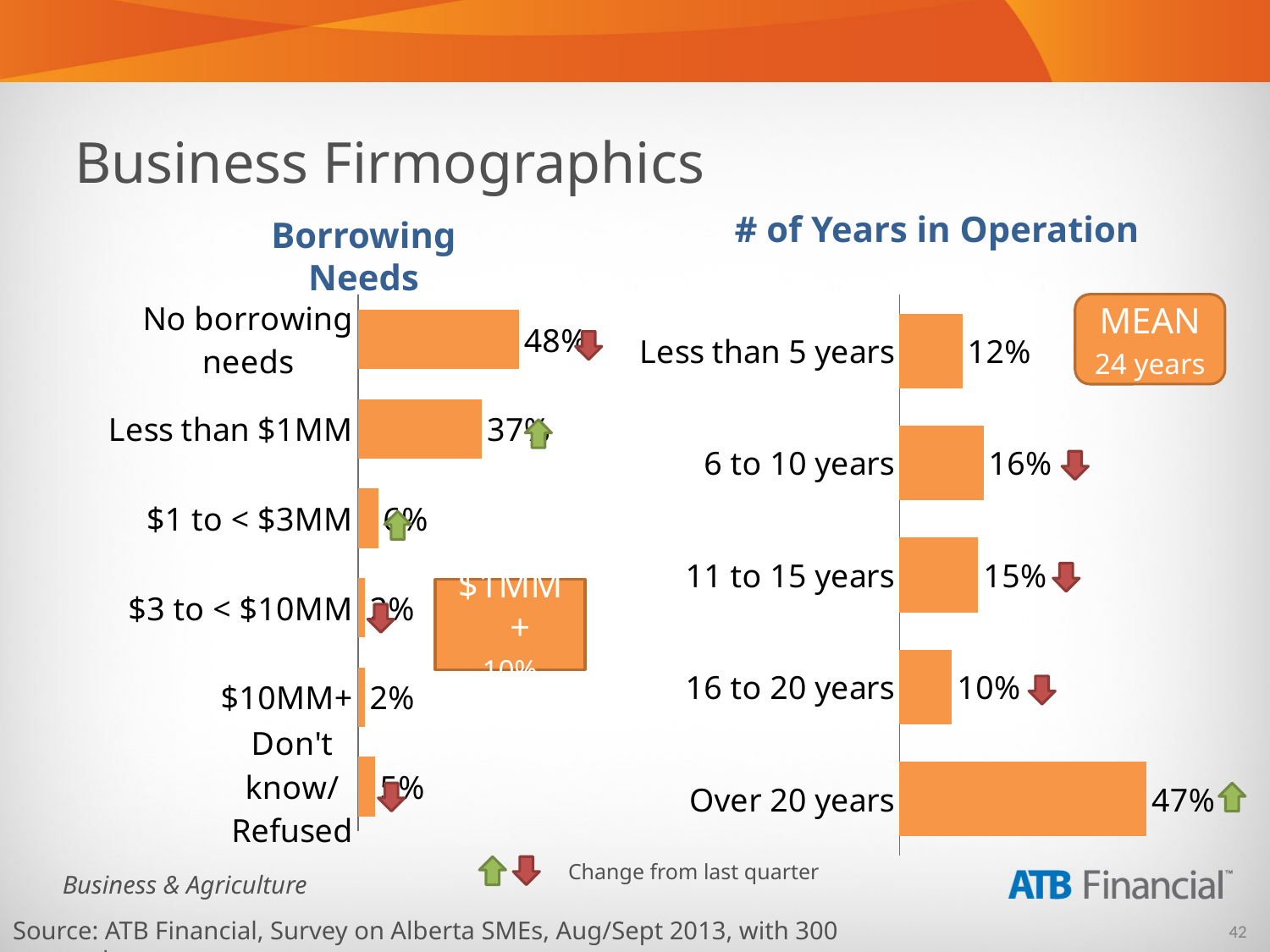
How many categories are shown in the # of Years in Operation chart? 5 In the # of Years in Operation chart, what percentage of businesses have been operating for over 20 years? 47% In the # of Years in Operation chart, which category has the lowest value? 16 to 20 years What is the mean number of years in operation shown on the slide? 24 years In the Borrowing Needs chart, what is the value for $10MM+? 2% In the # of Years in Operation chart, what is the value for 6 to 10 years? 16% In the Borrowing Needs chart, what is the difference between No borrowing needs and Less than $1MM? 11 percentage points In the Borrowing Needs chart, what is the value for Less than $1MM? 37% In the # of Years in Operation chart, what is the difference between Over 20 years and 16 to 20 years? 37 percentage points In the Borrowing Needs chart, which category has the highest value? No borrowing needs In the Borrowing Needs chart, what percentage of businesses have no borrowing needs? 48% In the # of Years in Operation chart, which is larger: Less than 5 years or 11 to 15 years? 11 to 15 years